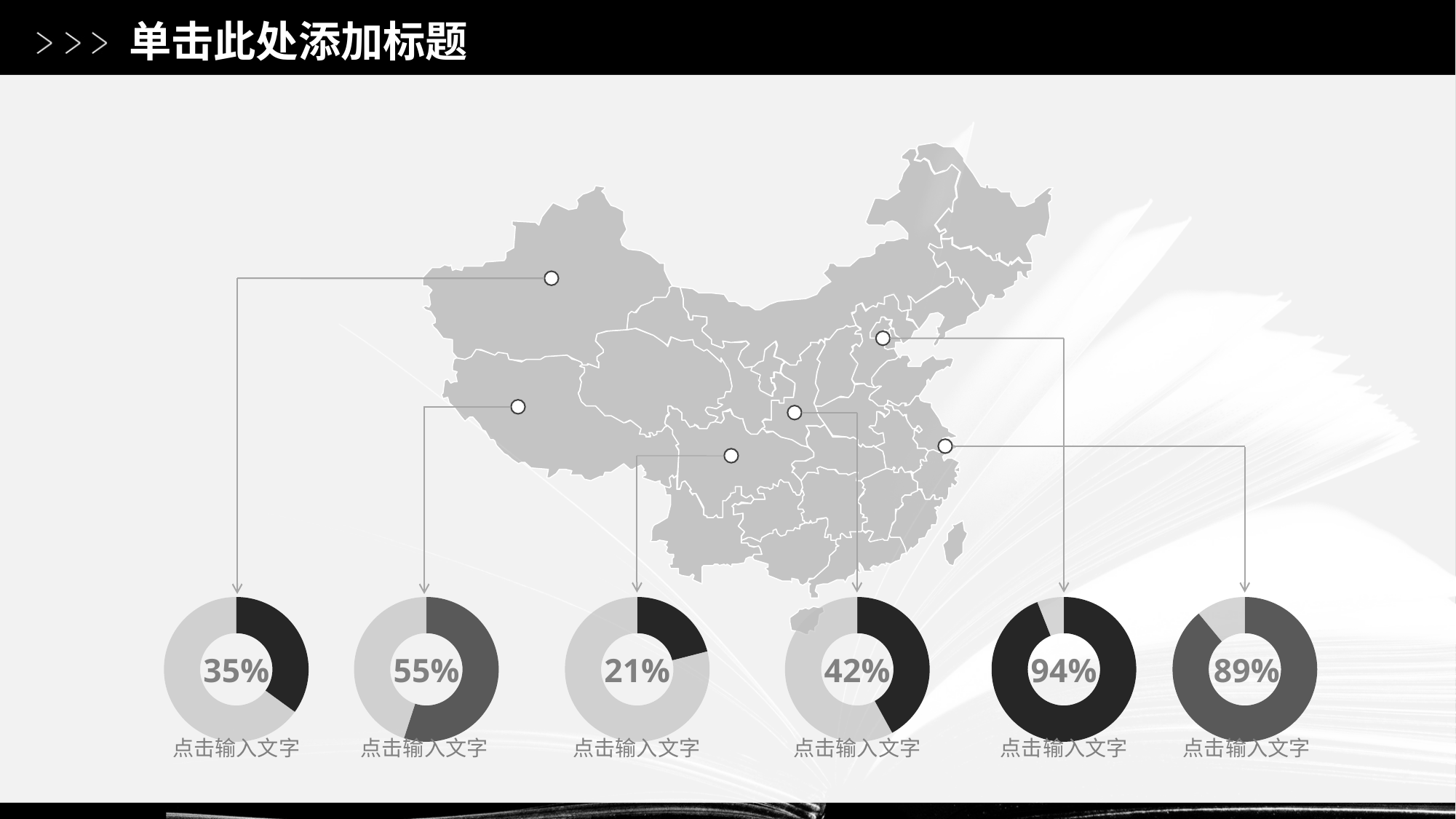
What is the difference between the value in the fifth donut chart (94%) and the value in the sixth donut chart (89%)? 5% What value is shown in the fourth donut chart from the left? 42% Which is larger: the value in the second donut chart or the value in the fourth donut chart? The second donut chart (55%) What value is shown in the sixth (rightmost) donut chart? 89% What value is shown in the first (leftmost) donut chart at the bottom of the slide? 35% What value is shown in the second donut chart from the left? 55% What value is shown in the third donut chart from the left? 21% What kind of chart is used to display the six percentages at the bottom of the slide? Donut (ring) chart Which donut chart shows the lowest percentage? The third from the left (21%) How many donut charts are shown along the bottom of the slide? 6 Which donut chart shows the highest percentage? The fifth from the left (94%) What value is shown in the fifth donut chart from the left? 94%